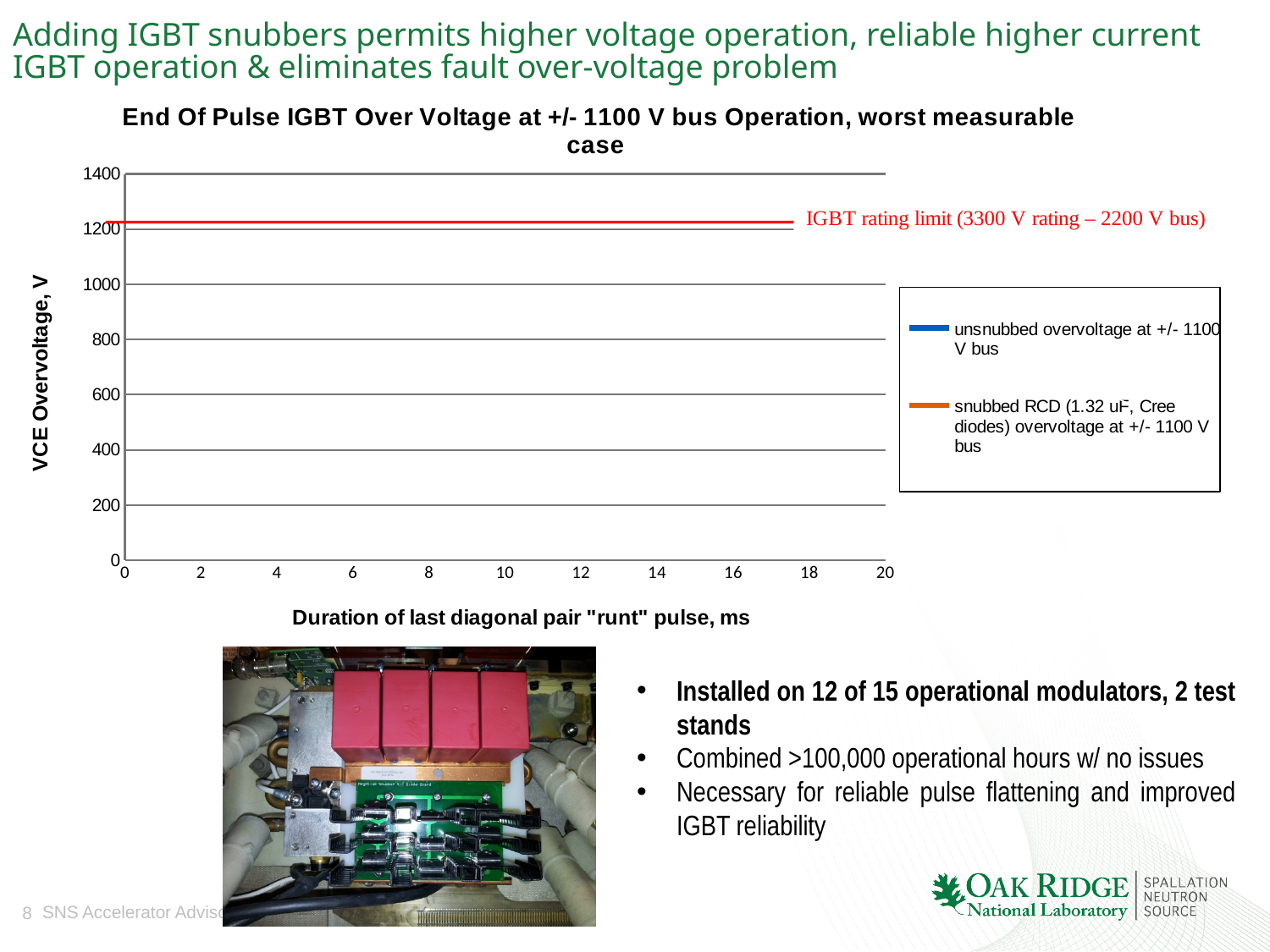
How many series does the chart's legend list? 2 What is the title of the chart? End Of Pulse IGBT Over Voltage at +/- 1100 V bus Operation, worst measurable case What is the label of the chart's x axis? Duration of last diagonal pair "runt" pulse, ms Is the red IGBT rating limit line on the chart greater or less than 1000 V? greater Is the red IGBT rating limit line on the chart greater or less than 1400 V? less What kind of chart is shown on the slide? line chart